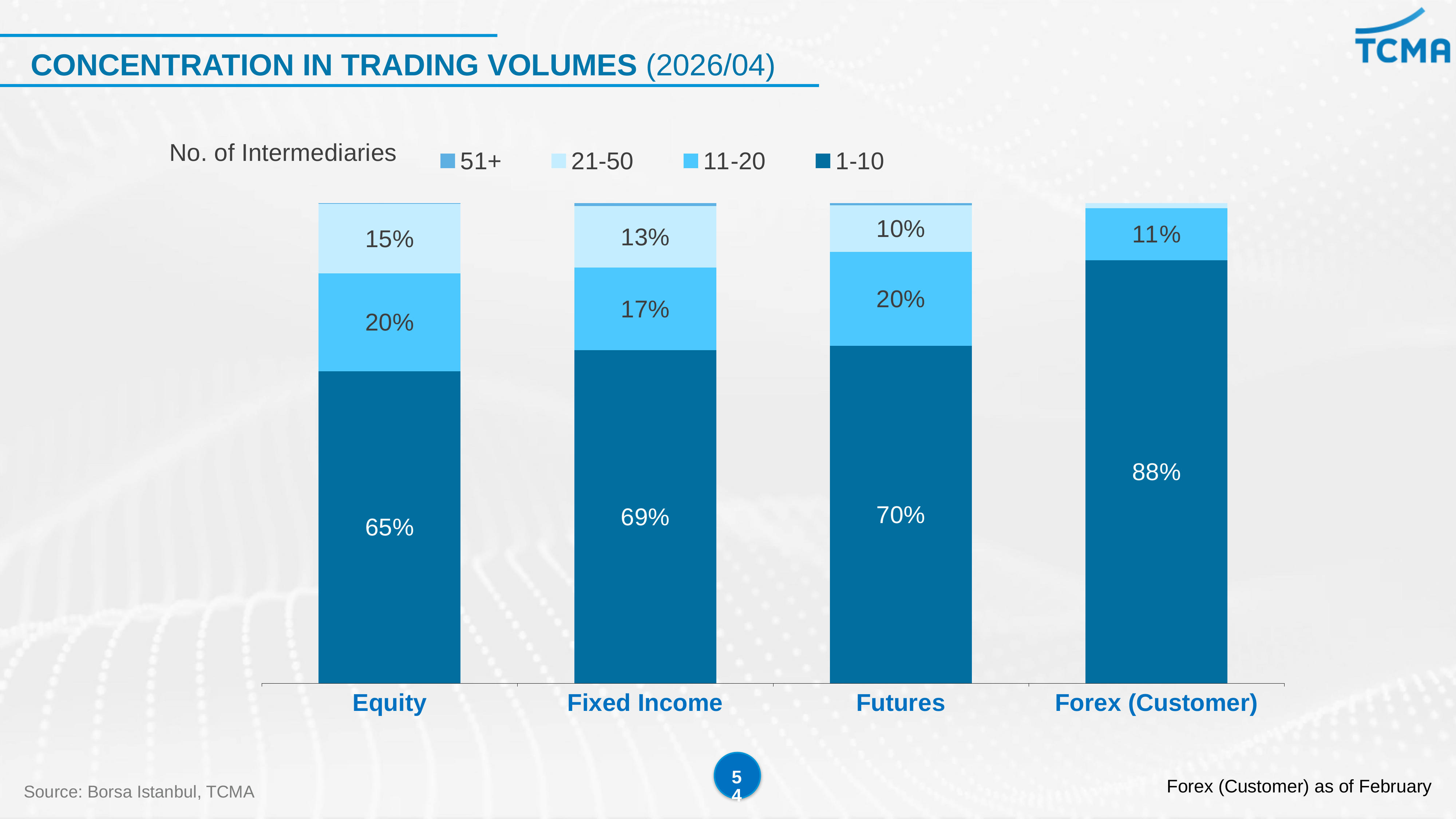
Which is larger: the 21-50 segment for Equity or the 21-50 segment for Fixed Income? Equity What is the value of the 21-50 segment for Futures? 10% Which category has the highest value for the 1-10 intermediaries group? Forex (Customer) What is the value of the 11-20 segment for Fixed Income? 17% What kind of chart is shown on the slide? Stacked bar chart What share of Equity trading volume is accounted for by the 1-10 intermediaries group? 65% What is the difference between the 1-10 segment for Forex (Customer) and the 1-10 segment for Equity? 23% How many categories are shown on the x axis? 4 Which category has the lowest value for the 1-10 intermediaries group? Equity What is the value of the 1-10 segment for Forex (Customer)? 88% What is the title of the chart on the slide? CONCENTRATION IN TRADING VOLUMES (2026/04) How many series does the legend list? 4